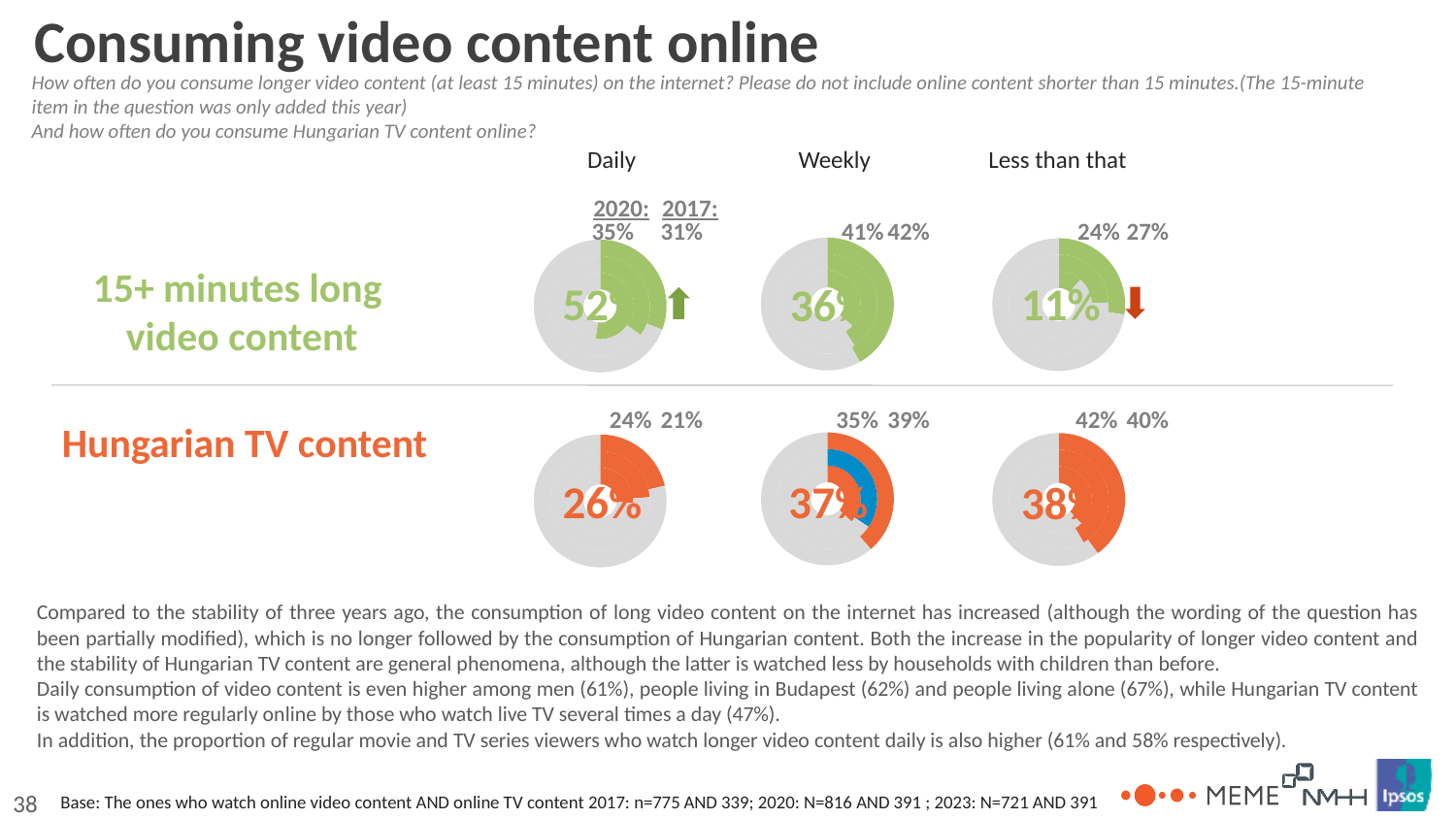
In the '15+ minutes long video content' row, what is the current value shown in the centre of the Daily donut chart? 52% In the 'Hungarian TV content' row, what is the difference between the 2020 and 2017 values for 'Less than that'? 2 percentage points In the 'Hungarian TV content' row, which frequency category has the lowest current value? Daily Which is larger: the current Daily value for '15+ minutes long video content' or the current Daily value for 'Hungarian TV content'? 15+ minutes long video content In the '15+ minutes long video content' row, what was the 2017 value for 'Less than that'? 27% In the '15+ minutes long video content' row, what is the difference between the current Daily value (52%) and the 2020 Daily value (35%)? 17 percentage points How many donut charts are shown on the slide in total? 6 In the 'Hungarian TV content' row, what is the current value shown in the centre of the Weekly donut chart? 37% In the '15+ minutes long video content' row, which frequency category (Daily, Weekly, Less than that) has the highest current value? Daily In the '15+ minutes long video content' row, what was the 2020 value for Daily consumption? 35% In the 'Hungarian TV content' row, what was the 2017 value for Weekly consumption? 39% What type of chart is used to display the values on this slide? Donut (pie) chart